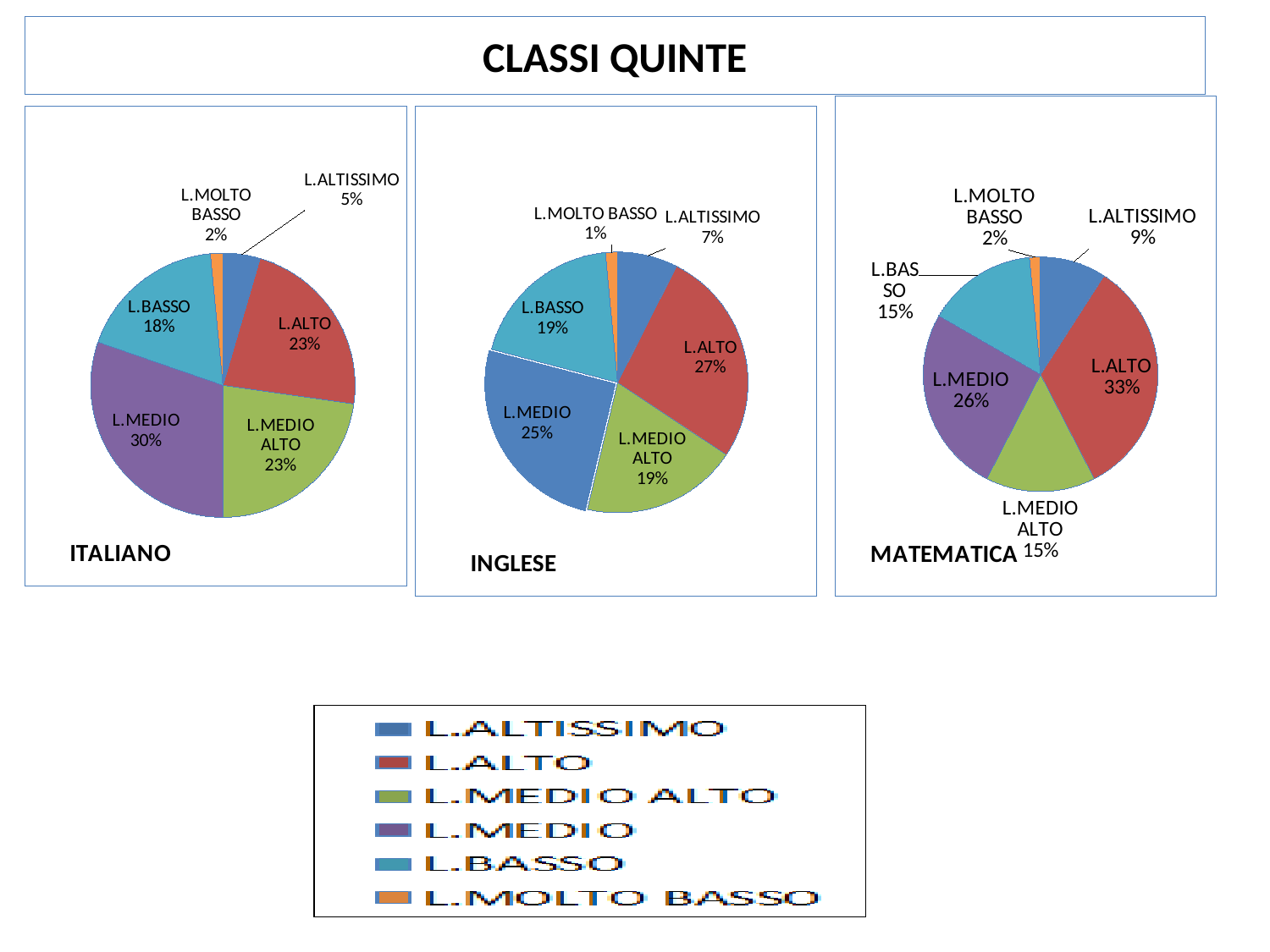
What kind of chart is the INGLESE chart? Pie chart In the MATEMATICA chart, which is larger, L.MEDIO or L.MEDIO ALTO? L.MEDIO In the ITALIANO chart, which category has the largest slice? L.MEDIO In the MATEMATICA chart, what share does L.ALTISSIMO have? 9% In the ITALIANO chart, what is the difference between the L.MEDIO share and the L.BASSO share? 12% In the INGLESE chart, what share does L.ALTO have? 27% How many pie charts are shown on the slide? 3 What is the title at the top of the slide? CLASSI QUINTE In the INGLESE chart, which category has the smallest slice? L.MOLTO BASSO In the ITALIANO chart, what share does L.MEDIO have? 30% In the MATEMATICA chart, which category has the largest slice? L.ALTO How many categories does the legend at the bottom of the slide list? 6